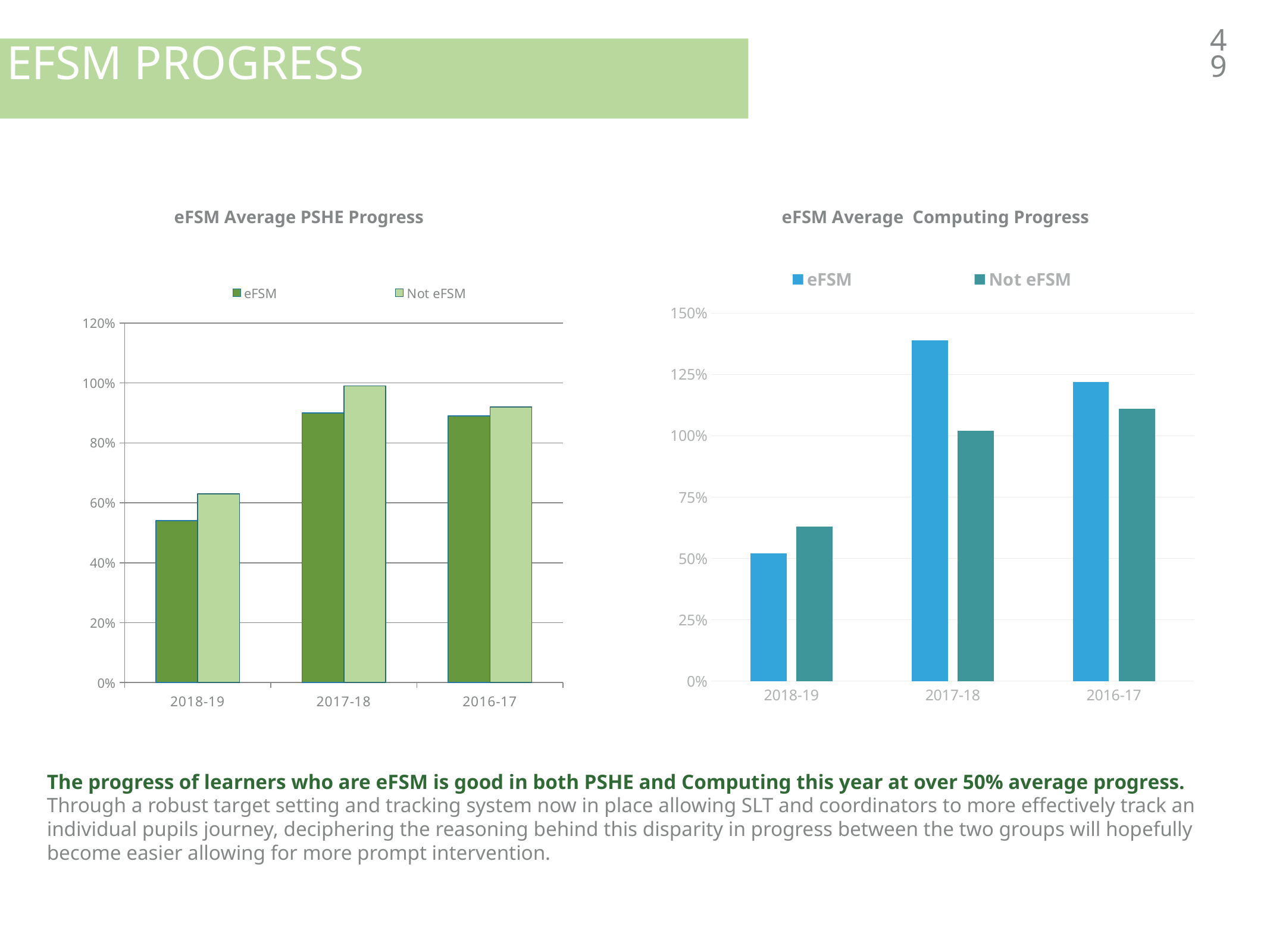
In the 'eFSM Average PSHE Progress' chart, which year has the highest Not eFSM value? 2017-18 In the 'eFSM Average PSHE Progress' chart, is the Not eFSM value for 2017-18 greater or less than 80%? greater In the 'eFSM Average PSHE Progress' chart, which series has the larger value for 2018-19, eFSM or Not eFSM? Not eFSM How many year categories are shown on the x axis of the 'eFSM Average PSHE Progress' chart? 3 In the 'eFSM Average PSHE Progress' chart, is the eFSM value for 2018-19 greater or less than 60%? less In the 'eFSM Average Computing Progress' chart, which year has the lowest Not eFSM value? 2018-19 How many series does the legend of the 'eFSM Average Computing Progress' chart list? 2 In the 'eFSM Average Computing Progress' chart, is the eFSM value for 2017-18 greater or less than 125%? greater In the 'eFSM Average Computing Progress' chart, which year has the highest eFSM value? 2017-18 In the 'eFSM Average Computing Progress' chart, which series has the larger value for 2017-18, eFSM or Not eFSM? eFSM What kind of chart is the 'eFSM Average PSHE Progress' chart? bar chart In the 'eFSM Average PSHE Progress' chart, which year has the lowest eFSM value? 2018-19